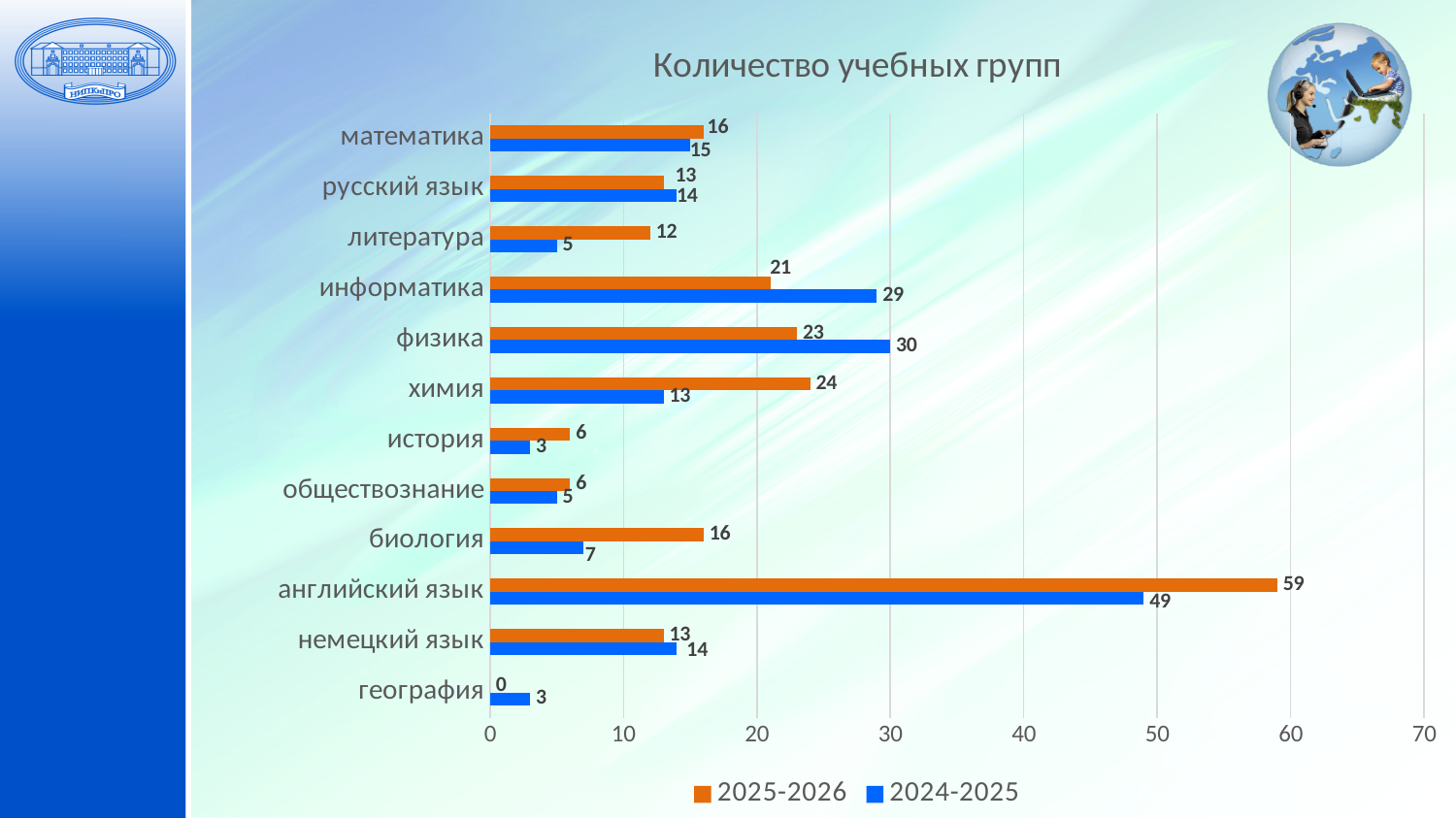
How many categories are shown on the chart? 12 What is the difference between the 2025-2026 and 2024-2025 values for информатика? 8 Which category has the highest value in the 2024-2025 series? английский язык Is the value for английский язык in the 2024-2025 series greater or less than 40? greater For химия, which series has the larger value, 2025-2026 or 2024-2025? 2025-2026 What is the value for литература in the 2024-2025 series? 5 What is the title of the chart? Количество учебных групп Which category has the lowest value in the 2025-2026 series? география How many series does the legend list? 2 What is the value for английский язык in the 2025-2026 series? 59 What is the value for физика in the 2024-2025 series? 30 What kind of chart is shown on the slide? bar chart